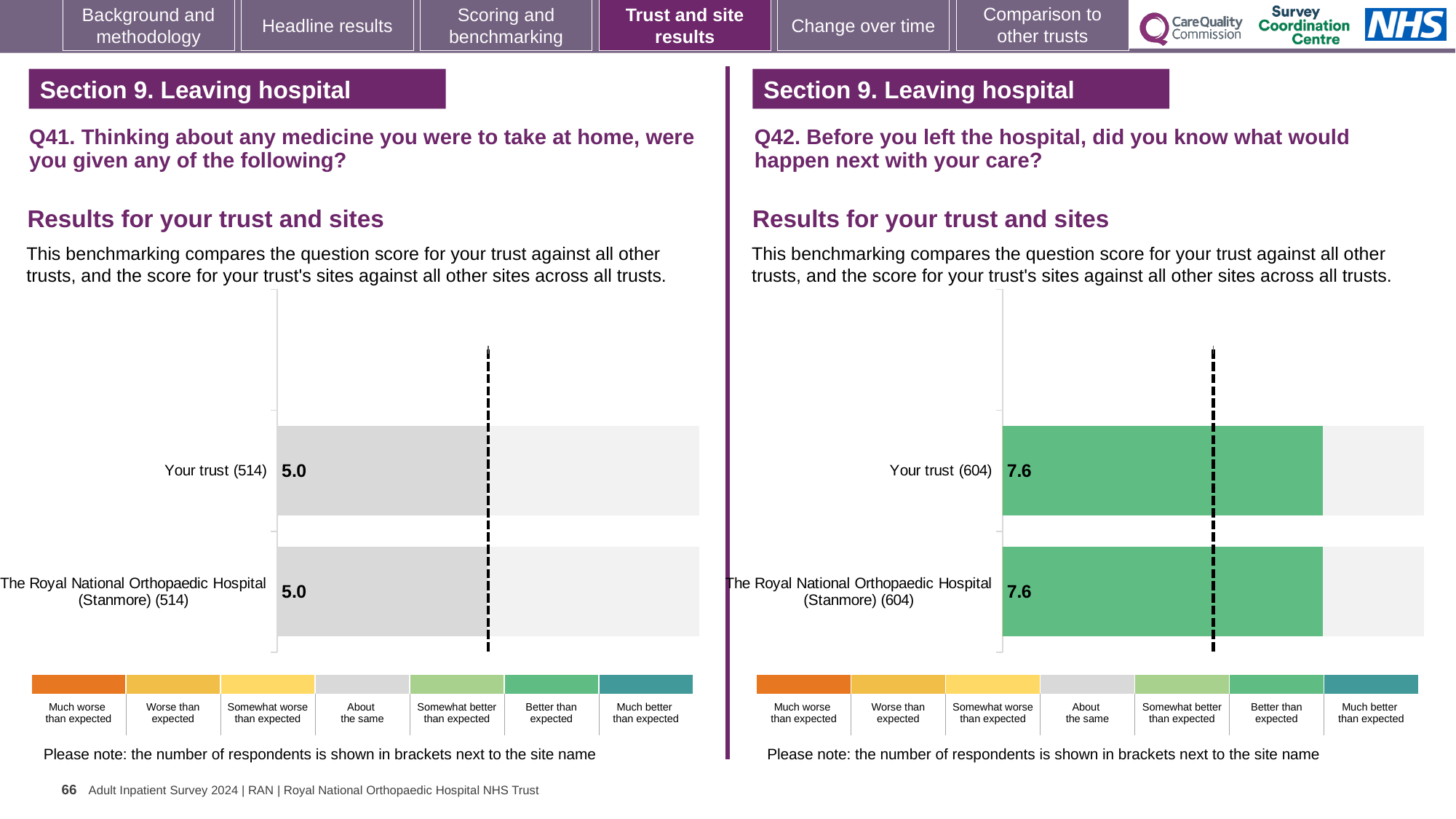
In the Q41 chart on the left, what is the score for The Royal National Orthopaedic Hospital (Stanmore)? 5.0 How many bars are plotted in the Q41 chart on the left? 2 In the Q42 chart on the right, how many respondents are shown in brackets for The Royal National Orthopaedic Hospital (Stanmore)? 604 In the Q41 chart on the left, how many respondents are shown in brackets for Your trust? 514 How many bars are plotted in the Q42 chart on the right? 2 In the Q42 chart on the right, what is the difference between the score for Your trust and the score for The Royal National Orthopaedic Hospital (Stanmore)? 0.0 What kind of chart is the Q42 chart on the right? Bar chart Is the score for Your trust in the Q42 chart on the right larger or smaller than the score for Your trust in the Q41 chart on the left? Larger In the Q42 chart on the right, what is the score for The Royal National Orthopaedic Hospital (Stanmore)? 7.6 In the Q42 chart on the right, what is the score for Your trust? 7.6 In the Q41 chart on the left, what is the score for Your trust? 5.0